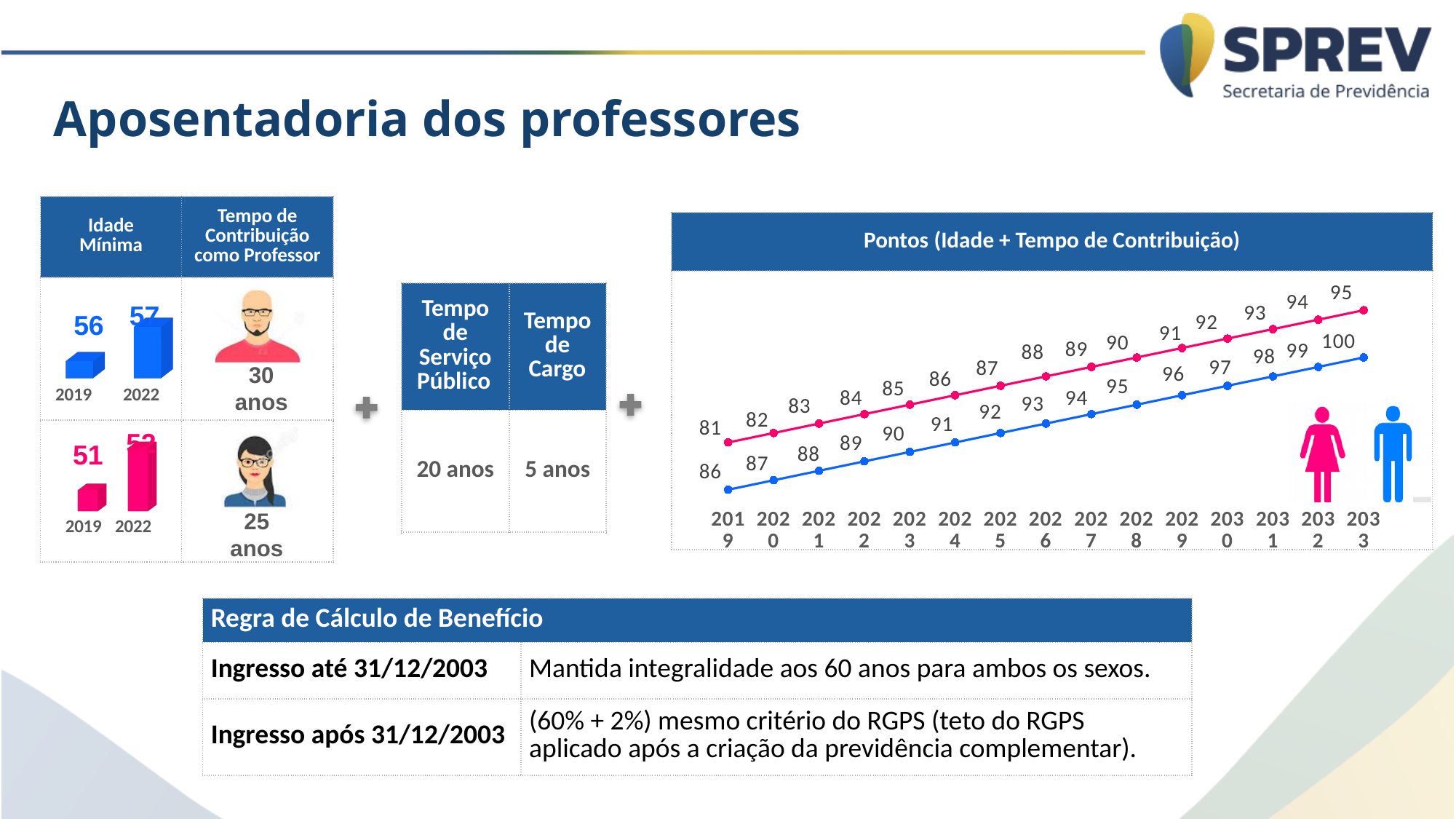
In the 'Pontos (Idade + Tempo de Contribuição)' chart, what is the value of the blue line in 2019? 86 In the 'Pontos (Idade + Tempo de Contribuição)' chart, what is the difference between the blue and pink values in 2019? 5 What type of chart is 'Pontos (Idade + Tempo de Contribuição)'? line chart In the 'Pontos (Idade + Tempo de Contribuição)' chart, what is the value of the blue line in 2033? 100 How many years are shown on the x axis of the 'Pontos (Idade + Tempo de Contribuição)' chart? 15 In the 'Pontos (Idade + Tempo de Contribuição)' chart, in which year does the blue line have its lowest value? 2019 In the 'Pontos (Idade + Tempo de Contribuição)' chart, what is the value of the pink line in 2025? 87 In the 'Pontos (Idade + Tempo de Contribuição)' chart, in which year does the pink line reach its highest value? 2033 In the 'Idade Mínima' bar chart, what is the blue value for 2019? 56 In the 'Pontos (Idade + Tempo de Contribuição)' chart, do the values rise or fall from 2019 to 2033? rise In the 'Pontos (Idade + Tempo de Contribuição)' chart, which line has the higher value in 2028, the blue or the pink? blue In the 'Pontos (Idade + Tempo de Contribuição)' chart, what is the value of the pink line in 2033? 95